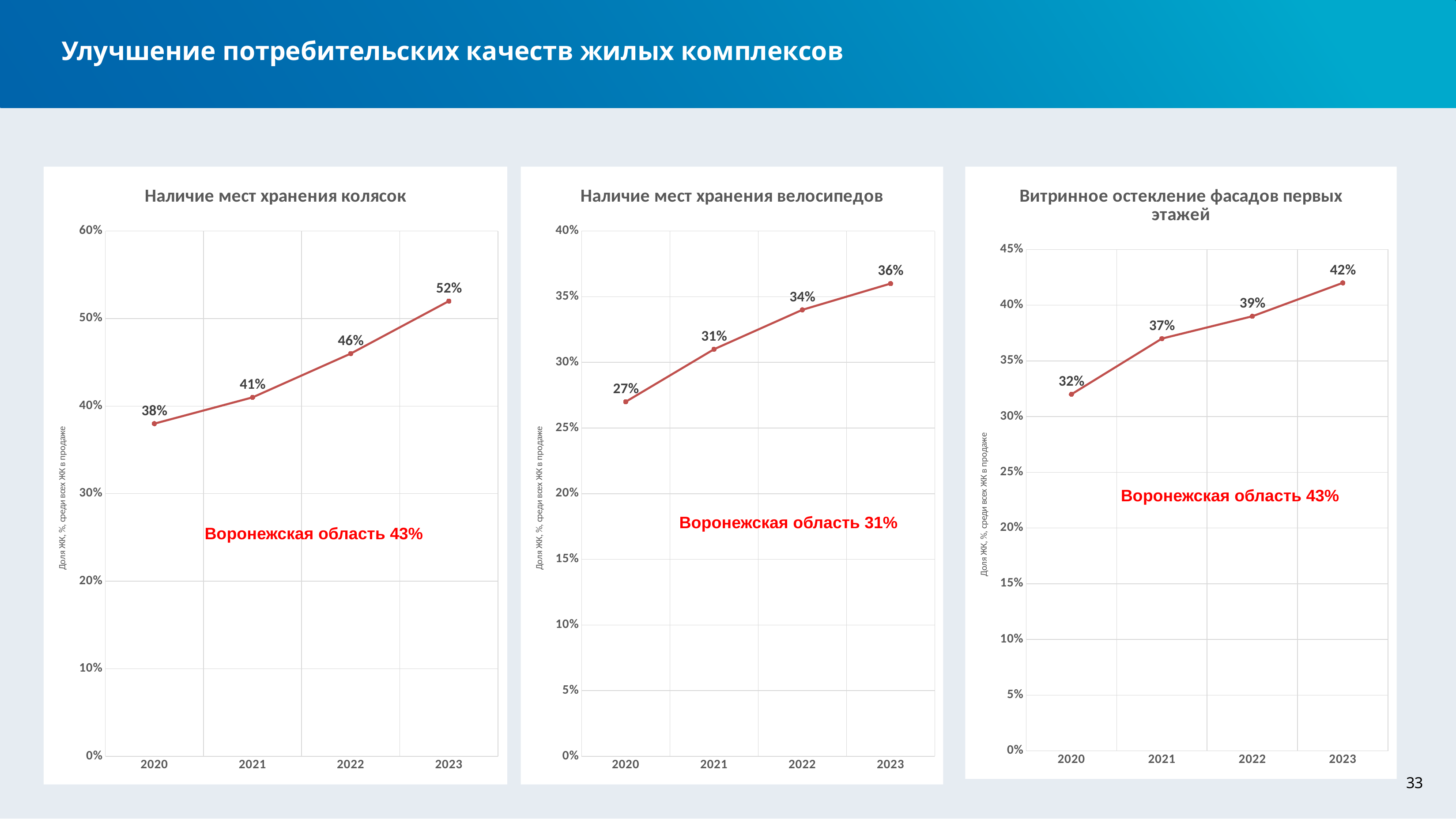
In the chart 'Наличие мест хранения велосипедов', do the values rise or fall from 2020 to 2023? Rise In the chart 'Наличие мест хранения колясок', what is the difference between the values for 2023 and 2020? 14% In the chart 'Витринное остекление фасадов первых этажей', what is the difference between the values for 2022 and 2021? 2% In the chart 'Наличие мест хранения колясок', what is the value for 2023? 52% In the chart 'Витринное остекление фасадов первых этажей', what is the value for 2021? 37% In the chart 'Наличие мест хранения велосипедов', what is the value for 2020? 27% How many data points are plotted in the chart 'Витринное остекление фасадов первых этажей'? 4 In the chart 'Наличие мест хранения велосипедов', which year has the lowest value? 2020 In the chart 'Наличие мест хранения колясок', which year has the highest value? 2023 What value is given for Воронежская область in the chart 'Наличие мест хранения велосипедов'? 31% What kind of chart is 'Наличие мест хранения колясок'? Line chart In the chart 'Наличие мест хранения велосипедов', which is larger: the value for 2022 or the value for 2021? 2022